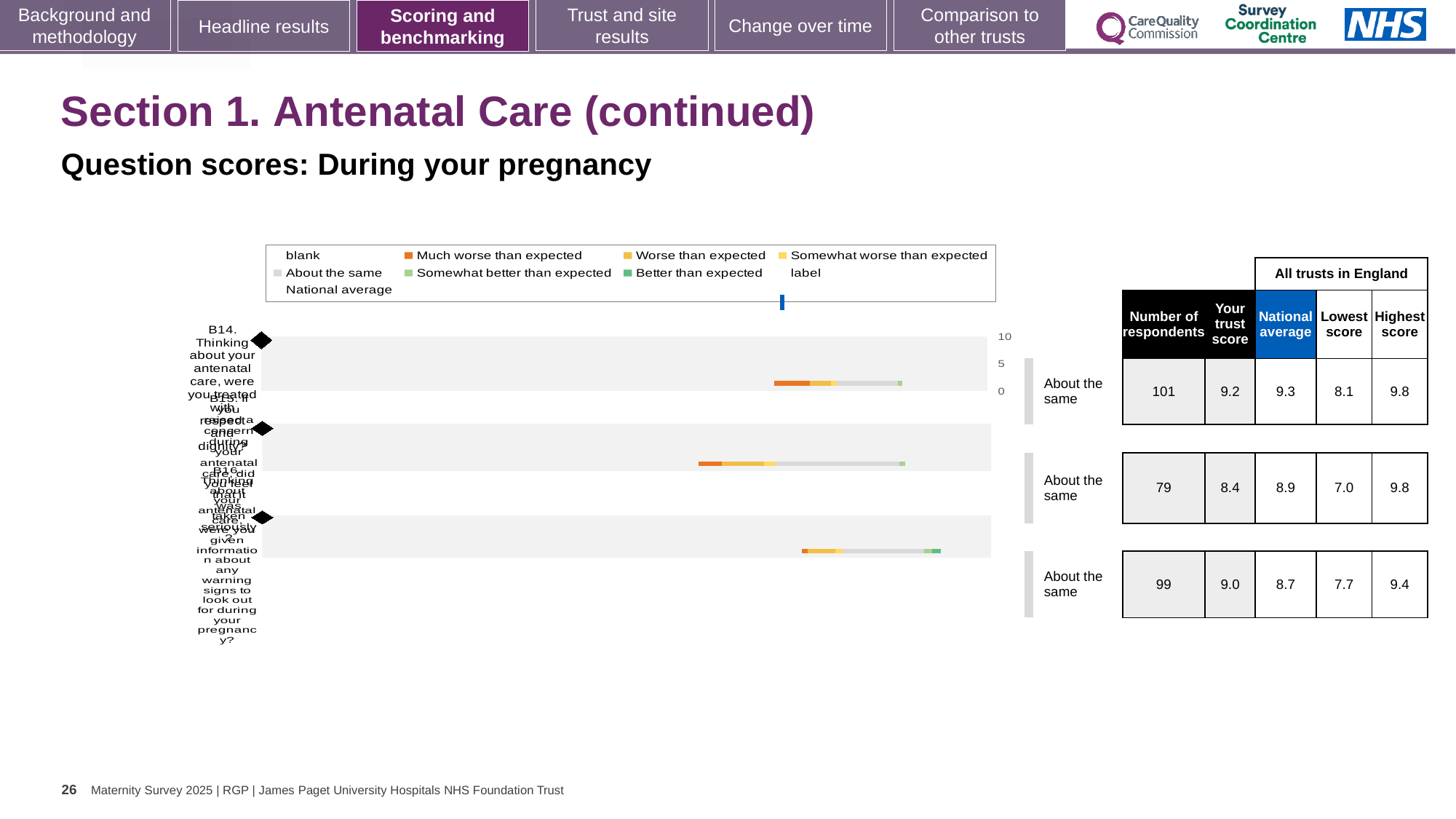
Which question row has the fewest respondents? the second row, 79 What is the national average for question B14 (treated with respect and dignity)? 9.3 For the third question row, which is larger: the trust score or the national average? the trust score (9.0) What is the lowest score across all trusts in England for the second question row? 7.0 What colour represents 'Much worse than expected' in the legend? orange How many question rows (bars) does the chart show? 3 What benchmark category is shown for all three questions? About the same What kind of chart is shown on the slide? bar chart Which question row has the highest 'Your trust score'? B14 (the first row), 9.2 What is the trust score for question B14 (treated with respect and dignity during antenatal care)? 9.2 What is the difference between the national average and the trust score for the second question row? 0.5 How many respondents answered question B14 (the first row)? 101